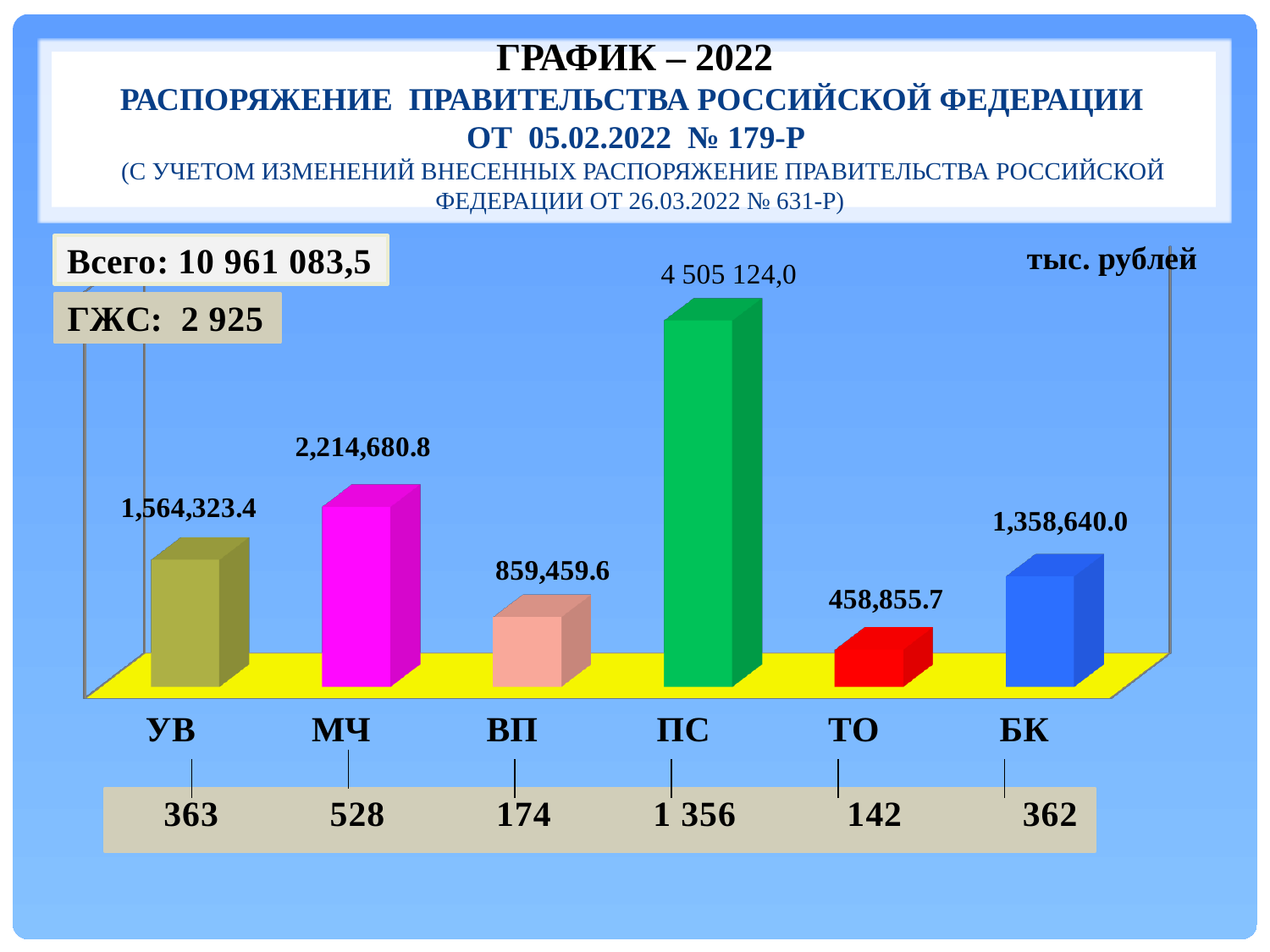
What unit is indicated for the chart values? тыс. рублей What number is shown in the row beneath the ПС bar? 1 356 How many categories are shown in the chart? 6 Which is larger, the value for УВ or the value for БК? УВ Which category has the highest value? ПС What is the difference between the values for МЧ and УВ? 650,357.4 What is the value shown for ТО? 458,855.7 What is the difference between the values for ВП and ТО? 400,603.9 Which category has the lowest value? ТО What kind of chart is shown on the slide? bar chart What is the value shown for МЧ? 2,214,680.8 What is the value shown for ПС? 4 505 124,0